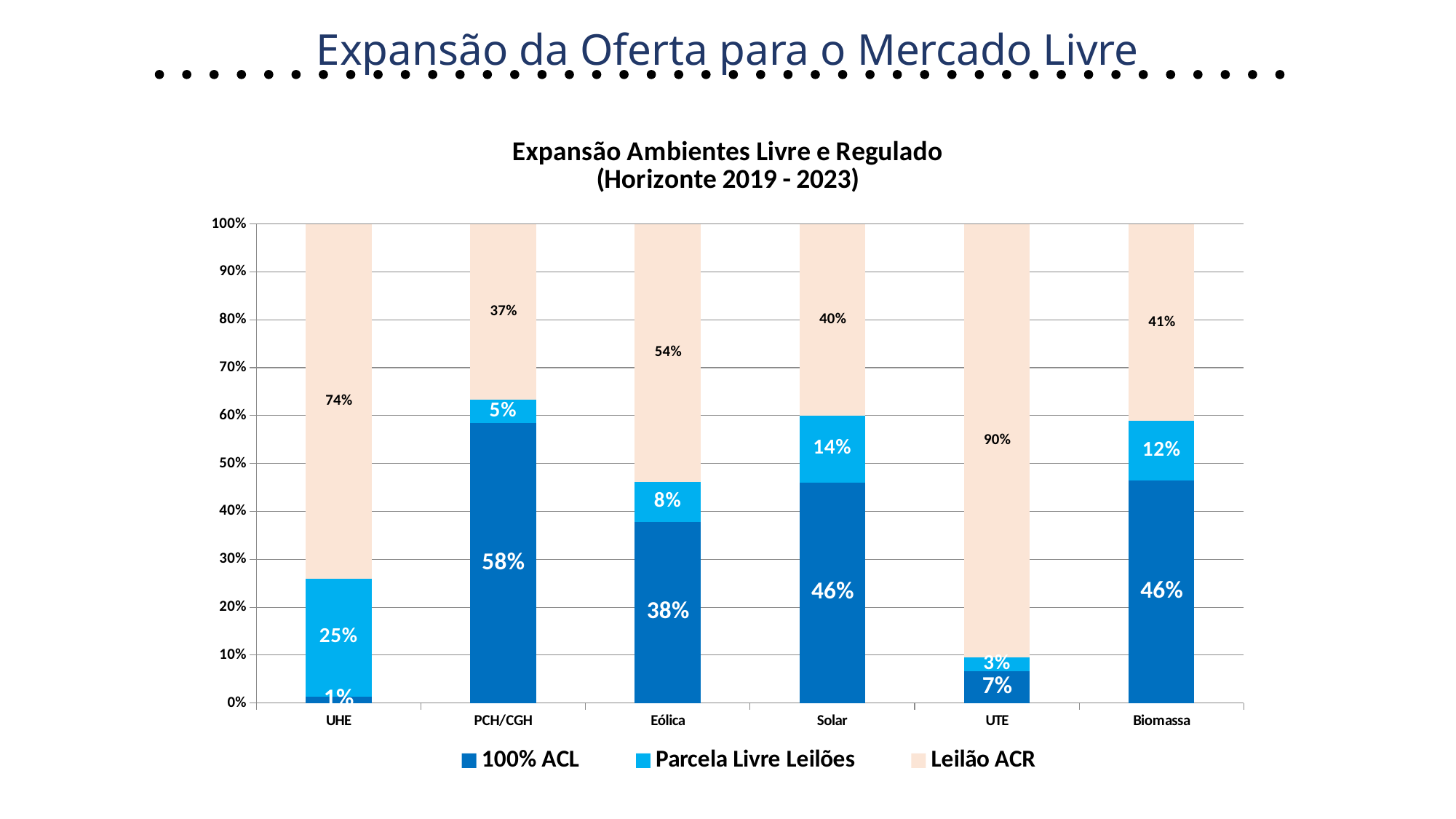
Which is larger, the Parcela Livre Leilões value for UHE or for Biomassa? UHE What kind of chart is shown on the slide? Stacked bar chart What is the title of the chart? Expansão Ambientes Livre e Regulado (Horizonte 2019 - 2023) How many series does the legend list? 3 What is the value of the 100% ACL series for PCH/CGH? 58% Which category has the highest value for the 100% ACL series? PCH/CGH What is the value of the Leilão ACR series for UTE? 90% What is the value of the Leilão ACR series for UHE? 74% How many categories are shown on the x axis? 6 Which category has the lowest value for the Leilão ACR series? PCH/CGH What is the value of the Parcela Livre Leilões series for Solar? 14% What is the difference between the Leilão ACR values for UTE and Solar? 50%